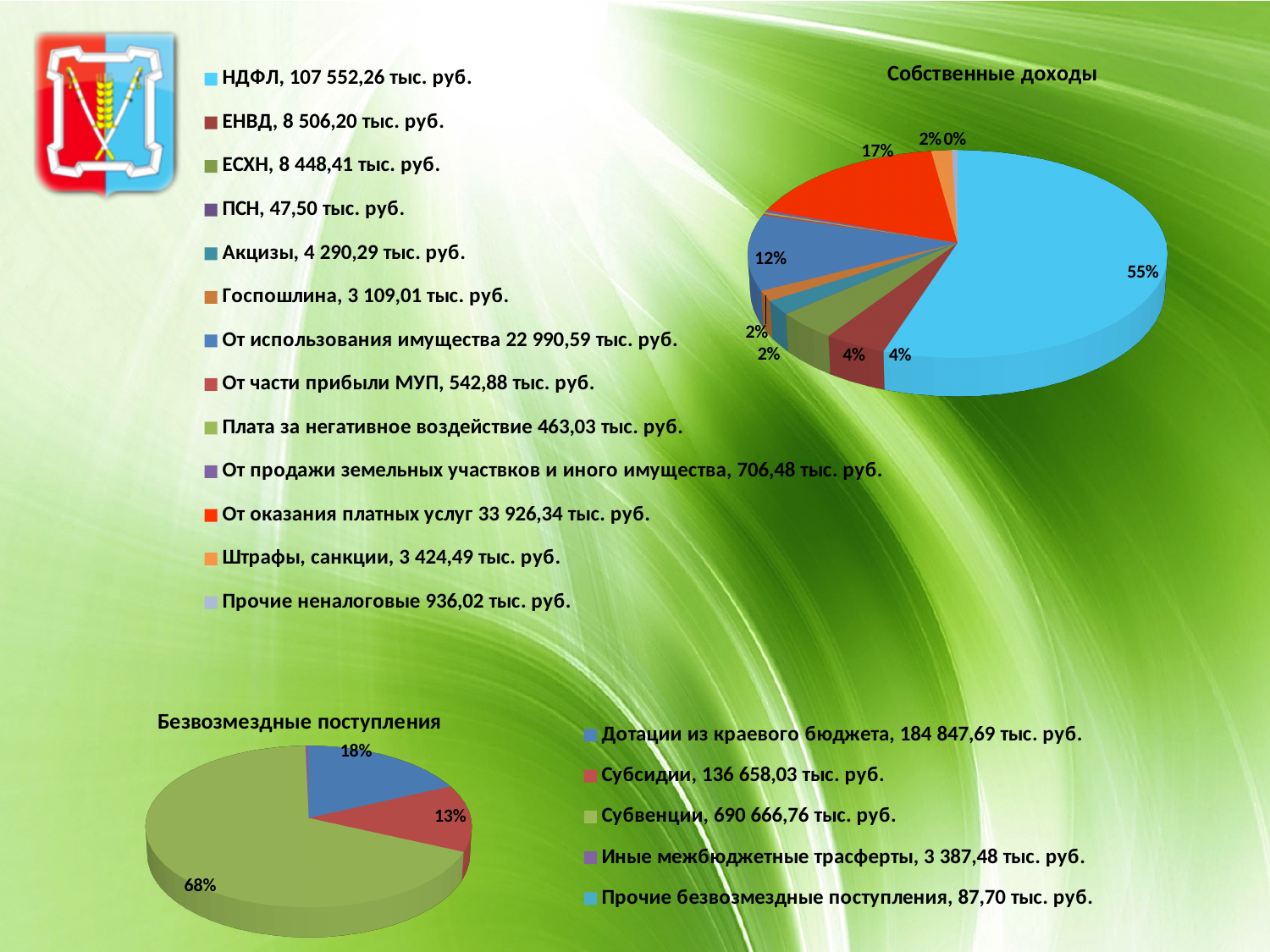
In the "Собственные доходы" chart, which category has the largest value? НДФЛ In the "Собственные доходы" chart, what is the value for От оказания платных услуг? 33 926,34 тыс. руб. How many categories does the legend of the "Безвозмездные поступления" chart list? 5 In the "Собственные доходы" chart, what is the value for НДФЛ? 107 552,26 тыс. руб. In the "Собственные доходы" chart, what share of the pie does НДФЛ take? 55% In the "Безвозмездные поступления" chart, what share of the pie does Субвенции take? 68% What type of chart is used for "Собственные доходы"? pie chart In the "Безвозмездные поступления" chart, which category has the smallest value? Прочие безвозмездные поступления How many categories does the legend of the "Собственные доходы" chart list? 13 In the "Безвозмездные поступления" chart, what is the value for Субвенции? 690 666,76 тыс. руб. In the "Собственные доходы" chart, which category has the smallest value? ПСН In the "Собственные доходы" chart, which is larger: ЕНВД or Акцизы? ЕНВД